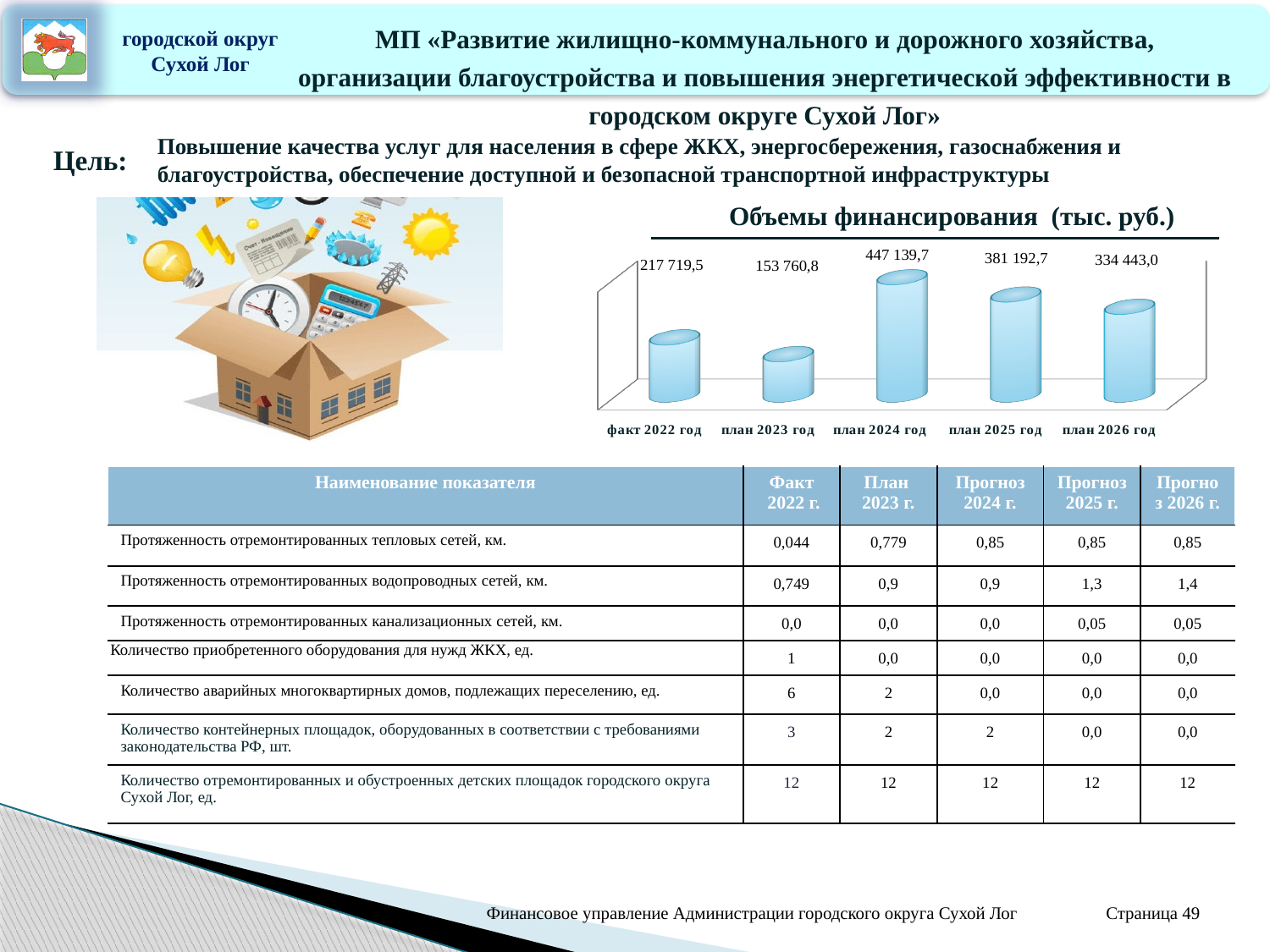
What is the value for план 2026 год in the Объемы финансирования chart? 334 443,0 Which category has the highest value in the Объемы финансирования chart? план 2024 год What kind of chart is the Объемы финансирования chart? bar chart What unit is given in the title of the chart on the slide? тыс. руб. What is the difference between план 2024 год and план 2025 год in the Объемы финансирования chart? 65 947,0 Do the values in the Объемы финансирования chart rise or fall from план 2024 год to план 2026 год? fall How many categories are shown in the Объемы финансирования chart? 5 What is the difference between факт 2022 год and план 2023 год in the Объемы финансирования chart? 63 958,7 Which is larger in the Объемы финансирования chart: план 2025 год or план 2026 год? план 2025 год Which category has the lowest value in the Объемы финансирования chart? план 2023 год What is the value for план 2024 год in the Объемы финансирования chart? 447 139,7 What is the value for факт 2022 год in the Объемы финансирования chart? 217 719,5